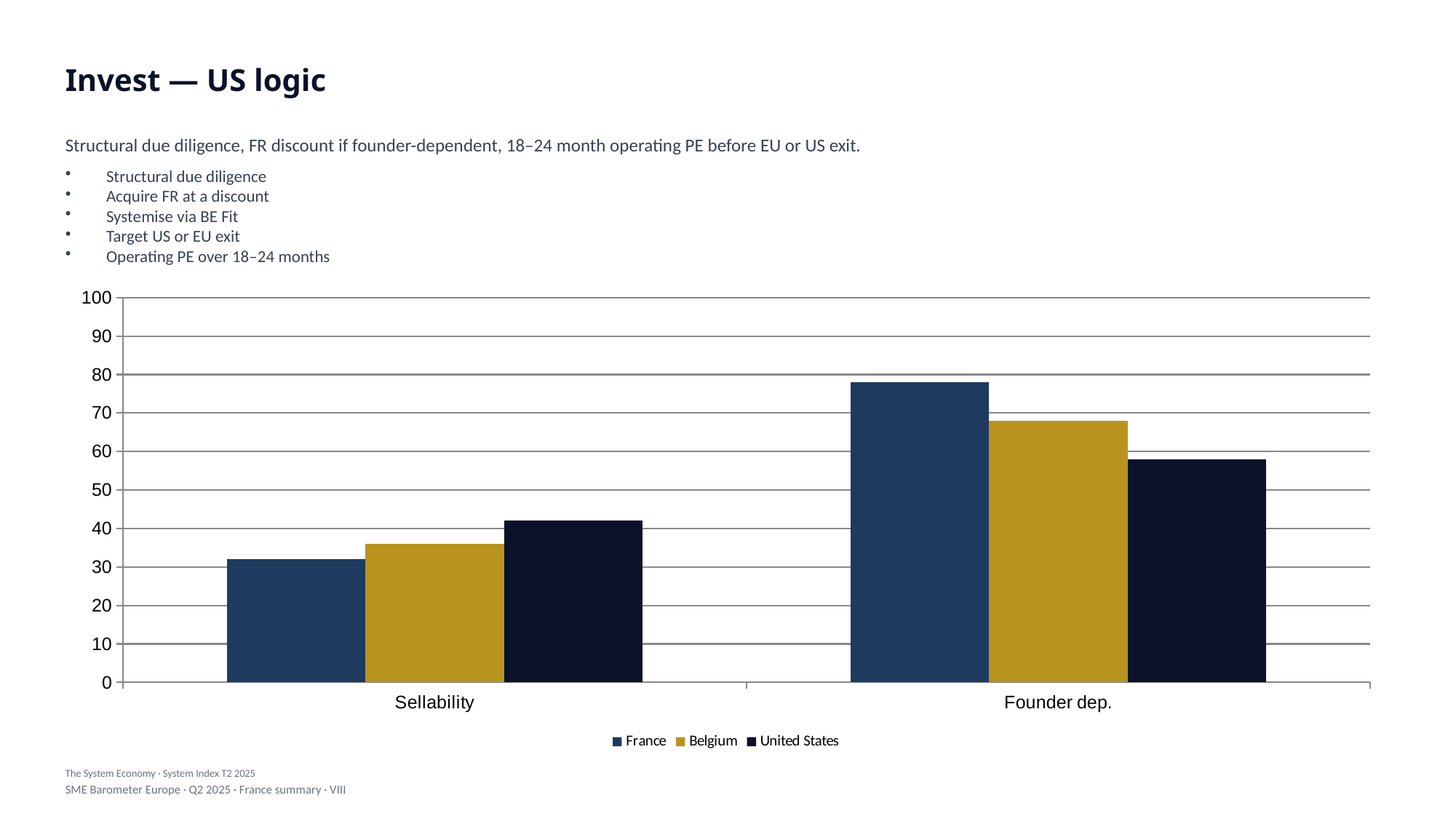
What are the three series listed in the legend? France, Belgium, United States Which is larger: the France value for Sellability or the France value for Founder dep.? Founder dep. Which series has the highest value for Sellability? United States Is the value for United States in Sellability greater or less than 50? less Which is larger for Founder dep.: Belgium or United States? Belgium Which series has the highest value for Founder dep.? France Is the value for Belgium in Founder dep. greater or less than 60? greater Which series has the lowest value for Sellability? France Is the value for France in Founder dep. greater or less than 70? greater How many categories are shown on the x axis? 2 What kind of chart is shown on the slide? bar chart How many series does the legend list? 3